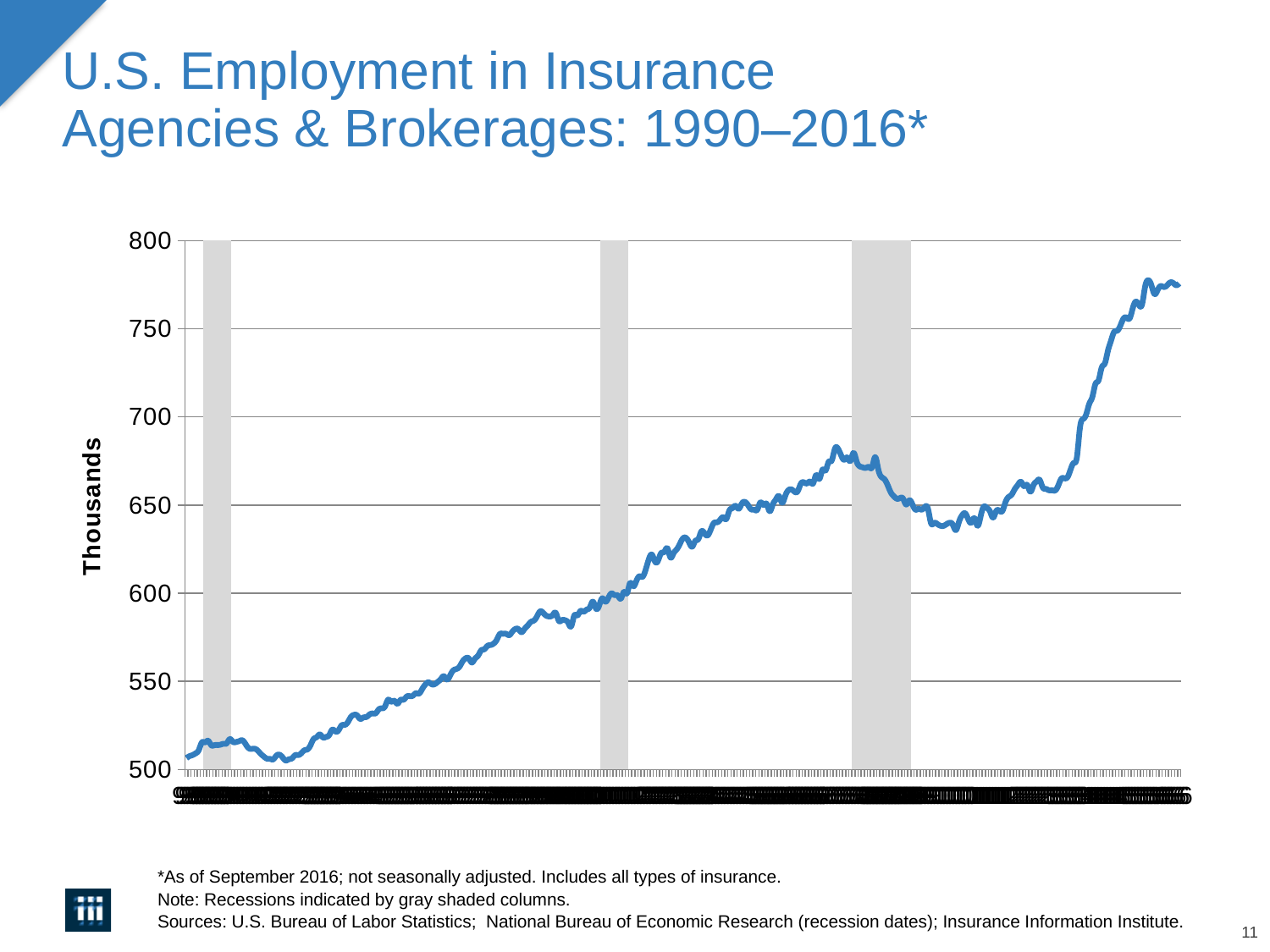
What is the label on the vertical axis of the chart? Thousands Is the value at the left end of the line (the earliest point) greater or less than 550? less How many data series are plotted on the chart? 1 What is the highest value shown on the vertical axis? 800 Does the line rise or fall during the third (rightmost) gray shaded recession column? fall Overall, does the line rise or fall from the left end of the chart to the right end? rise How many gray shaded recession columns appear on the chart? 3 What is the title of the chart on the slide? U.S. Employment in Insurance Agencies & Brokerages: 1990–2016* What kind of chart is shown on the slide? line chart Is the lowest point of the line greater or less than 550? less Is the value at the right end of the line (the most recent point) greater or less than 750? greater